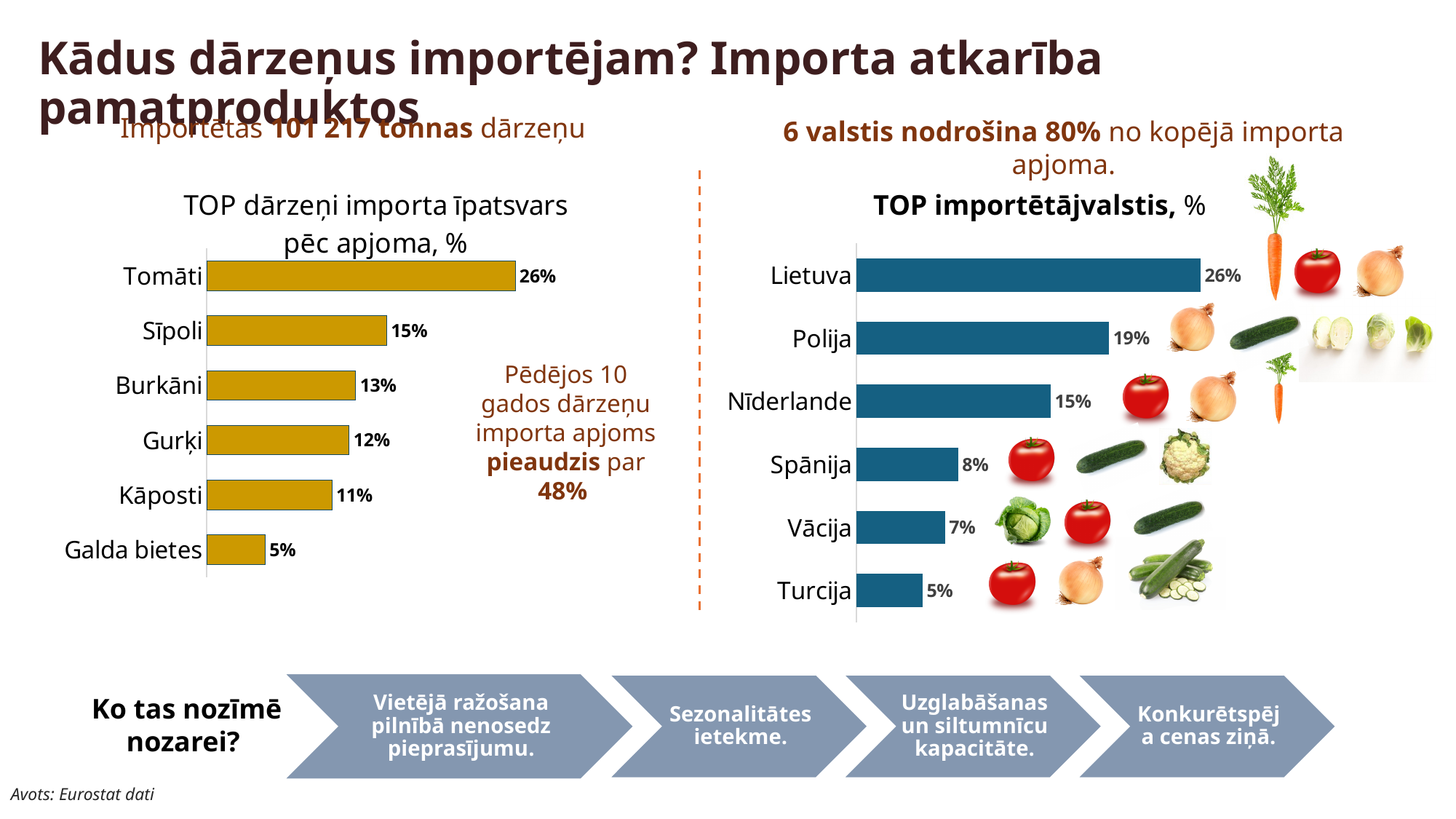
In the chart 'TOP importētājvalstis, %', what is the value for Polija? 19% In the chart 'TOP importētājvalstis, %', which is larger, the value for Nīderlande or the value for Spānija? Nīderlande What kind of chart is 'TOP dārzeņi importa īpatsvars pēc apjoma, %'? Bar chart In the chart 'TOP dārzeņi importa īpatsvars pēc apjoma, %', what is the difference between the values for Tomāti and Burkāni? 13% In the chart 'TOP dārzeņi importa īpatsvars pēc apjoma, %', how many categories are shown? 6 In the chart 'TOP dārzeņi importa īpatsvars pēc apjoma, %', what is the value for Sīpoli? 15% In the chart 'TOP importētājvalstis, %', what is the difference between the values for Lietuva and Polija? 7% In the chart 'TOP dārzeņi importa īpatsvars pēc apjoma, %', which category has the highest value? Tomāti In the chart 'TOP importētājvalstis, %', which country has the lowest value? Turcija In the chart 'TOP importētājvalstis, %', which country has the highest value? Lietuva In the chart 'TOP importētājvalstis, %', what is the value for Vācija? 7% In the chart 'TOP dārzeņi importa īpatsvars pēc apjoma, %', which category has the lowest value? Galda bietes